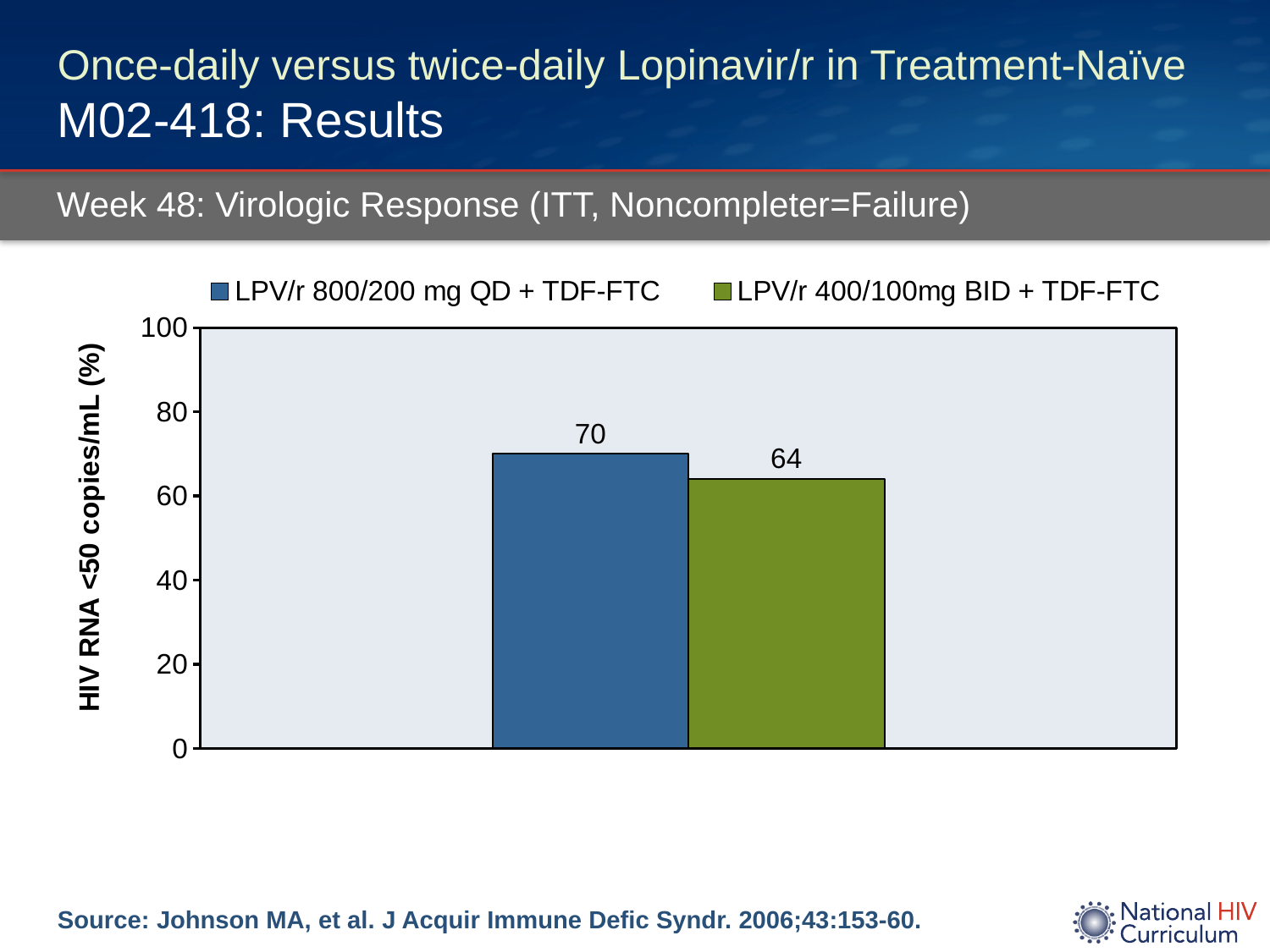
What is the label of the y axis? HIV RNA <50 copies/mL (%) How many bars are plotted on the chart? 2 Which series has the lowest value? LPV/r 400/100mg BID + TDF-FTC What is the value for LPV/r 400/100mg BID + TDF-FTC? 64 What is the difference between the values for LPV/r 800/200 mg QD + TDF-FTC and LPV/r 400/100mg BID + TDF-FTC? 6 Is the value for LPV/r 400/100mg BID + TDF-FTC greater or less than 80? less Which is larger, the value for LPV/r 800/200 mg QD + TDF-FTC or the value for LPV/r 400/100mg BID + TDF-FTC? LPV/r 800/200 mg QD + TDF-FTC How many series does the legend list? 2 Is the value for LPV/r 800/200 mg QD + TDF-FTC greater or less than 60? greater What is the value for LPV/r 800/200 mg QD + TDF-FTC? 70 Which series has the highest value? LPV/r 800/200 mg QD + TDF-FTC What kind of chart is shown on the slide? bar chart